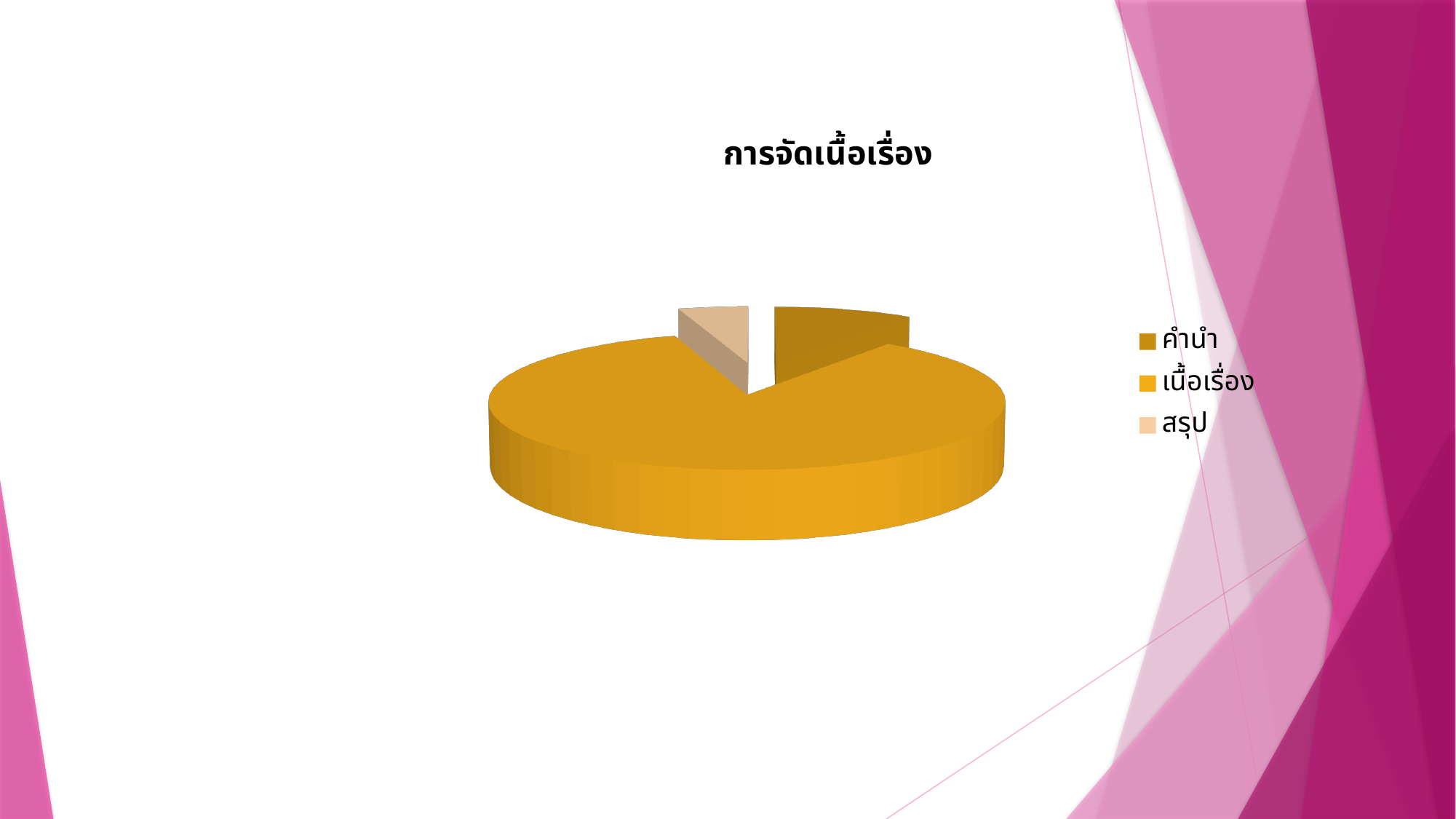
Which slice is larger, เนื้อเรื่อง or คำนำ? เนื้อเรื่อง Which category has the largest slice of the pie? เนื้อเรื่อง What kind of chart is shown on the slide? pie chart How many entries does the legend list? 3 What is the title of the chart? การจัดเนื้อเรื่อง Which category has the smallest slice of the pie? สรุป Which slice is larger, คำนำ or สรุป? คำนำ Which legend entry is shown in the lightest (tan) colour? สรุป How many slices does the pie chart have? 3